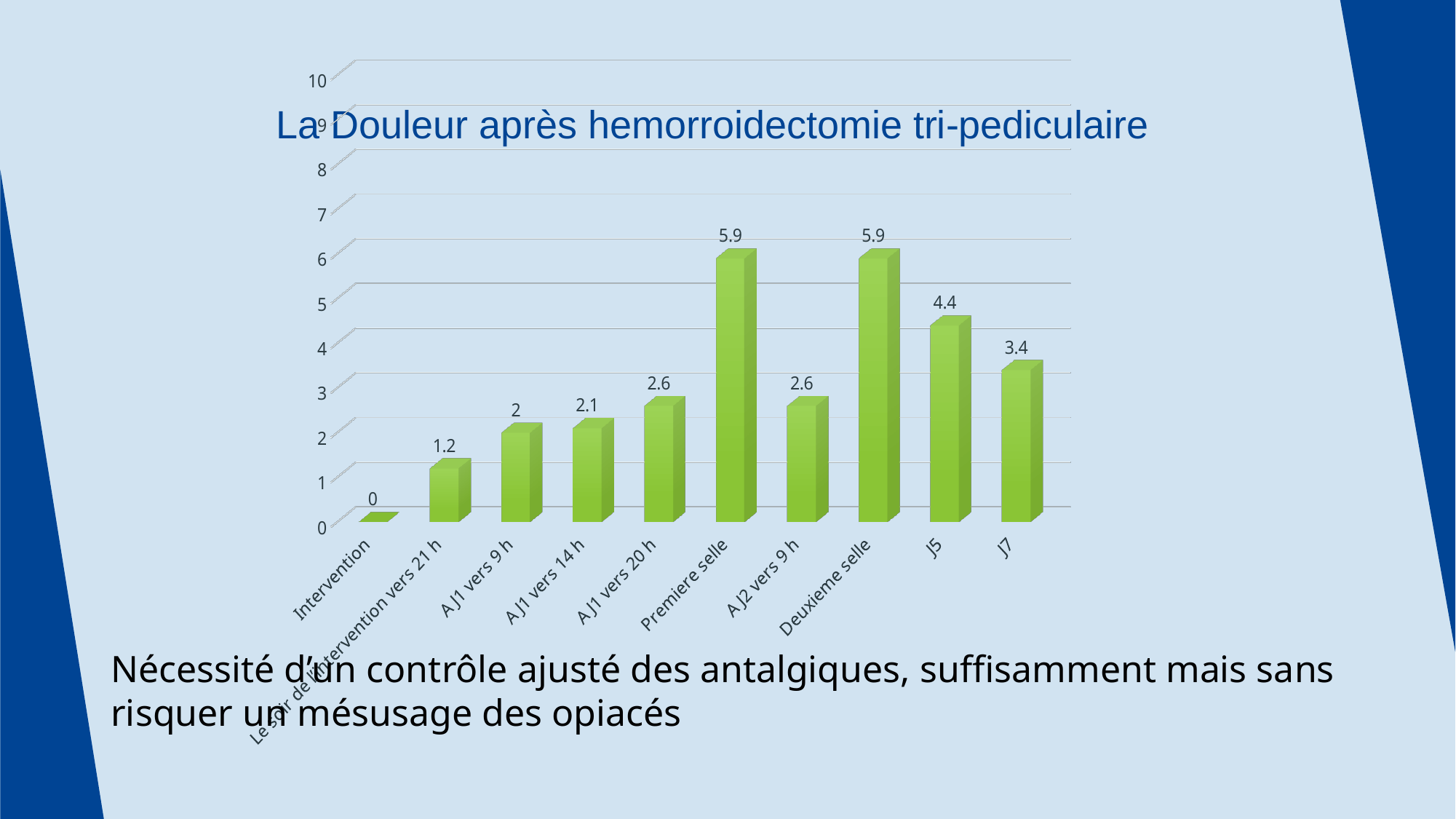
What is the value for J7? 3.4 What is the value for Premiere selle? 5.9 Which is larger, the value for A J1 vers 9 h or the value for J7? J7 How many categories are shown on the x axis? 10 What is the difference between the values for Deuxieme selle and A J2 vers 9 h? 3.3 What is the title of the chart? La Douleur après hemorroidectomie tri-pediculaire Which category has the lowest value? Intervention What is the highest value shown in the chart? 5.9 What is the difference between the values for J5 and J7? 1 What is the value for A J1 vers 14 h? 2.1 What is the value for J5? 4.4 What kind of chart is shown on the slide? Bar chart